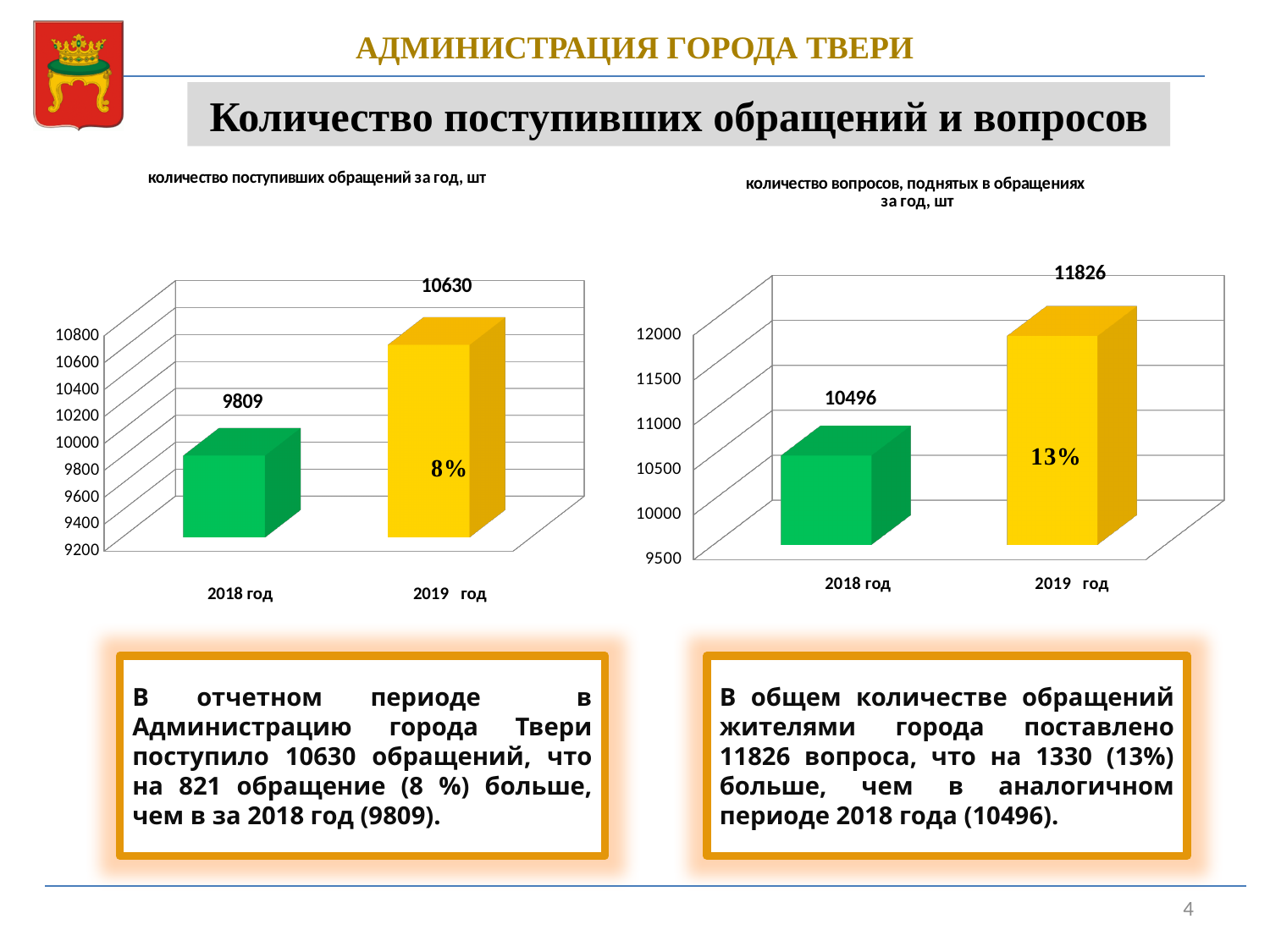
In the right chart (количество вопросов, поднятых в обращениях за год, шт), what is the value for 2018 год? 10496 In the right chart, is the value for 2018 год larger or smaller than the value for 2019 год? smaller What type of chart is the right chart? bar chart In the right chart, what is the difference between the 2019 год and 2018 год values? 1330 In the left chart (количество поступивших обращений за год, шт), what is the value for 2019 год? 10630 In the left chart (количество поступивших обращений за год, шт), what is the value for 2018 год? 9809 In the right chart (количество вопросов, поднятых в обращениях за год, шт), what is the value for 2019 год? 11826 In the left chart, which year has the higher value? 2019 год In the left chart, what is the difference between the 2019 год and 2018 год values? 821 What percentage label is printed on the 2019 год bar in the right chart? 13% In the right chart, which year has the lower value? 2018 год How many categories are shown in the left chart? 2